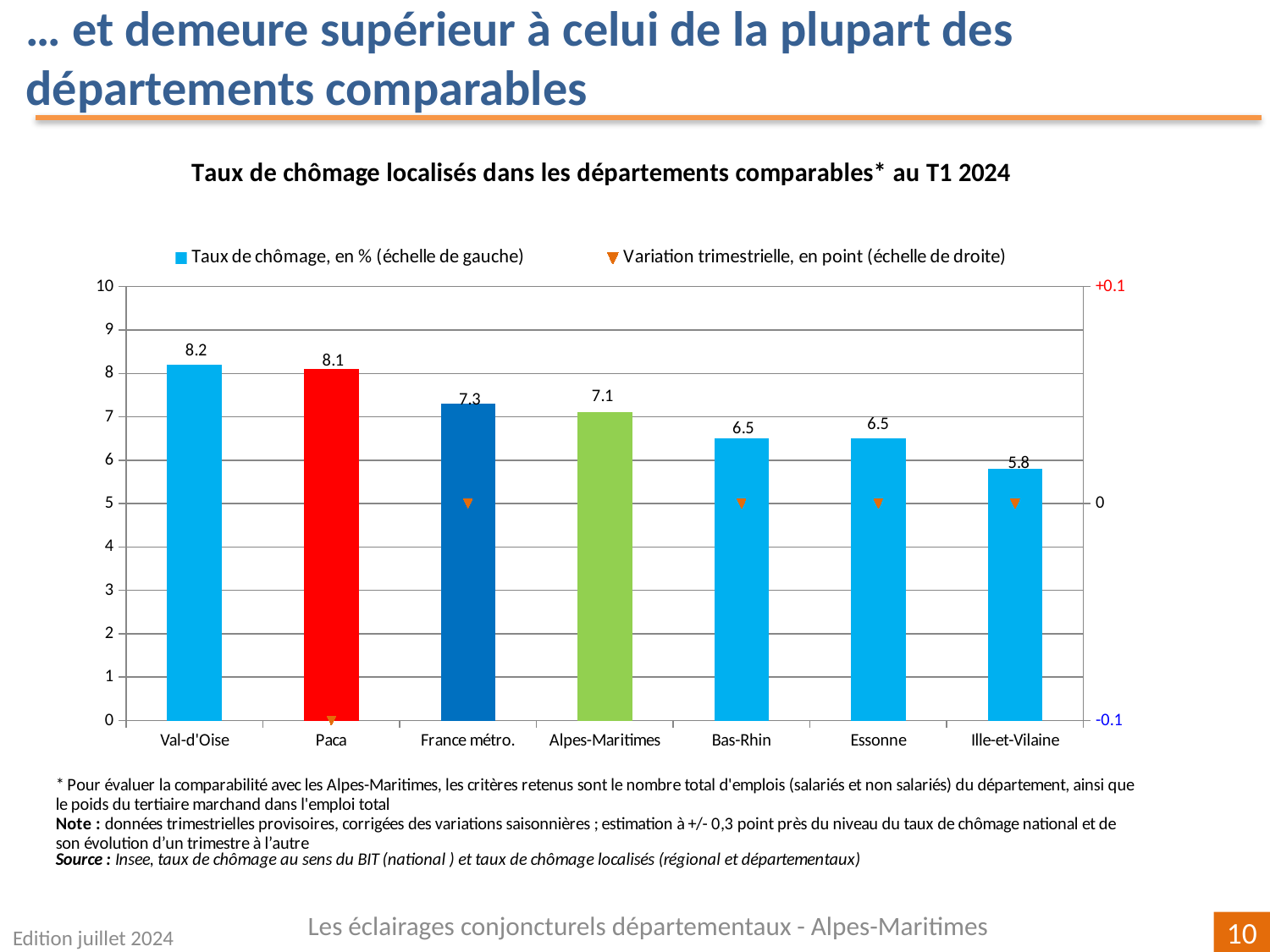
How many series does the legend list? 2 How many categories (departments/areas) are shown on the x axis? 7 Which category has the highest unemployment rate? Val-d'Oise What is the unemployment rate shown for Ille-et-Vilaine? 5.8 What is the unemployment rate shown for Val-d'Oise? 8.2 Which category has the lowest unemployment rate? Ille-et-Vilaine What colour is the bar for Paca? Red What is the difference between the unemployment rates of Val-d'Oise and Alpes-Maritimes? 1.1 Which has a higher unemployment rate, France métro. or Alpes-Maritimes? France métro. Is the unemployment rate for Paca greater or less than 8? greater What is the unemployment rate shown for Alpes-Maritimes? 7.1 What kind of chart is used to show the unemployment rates? Bar chart